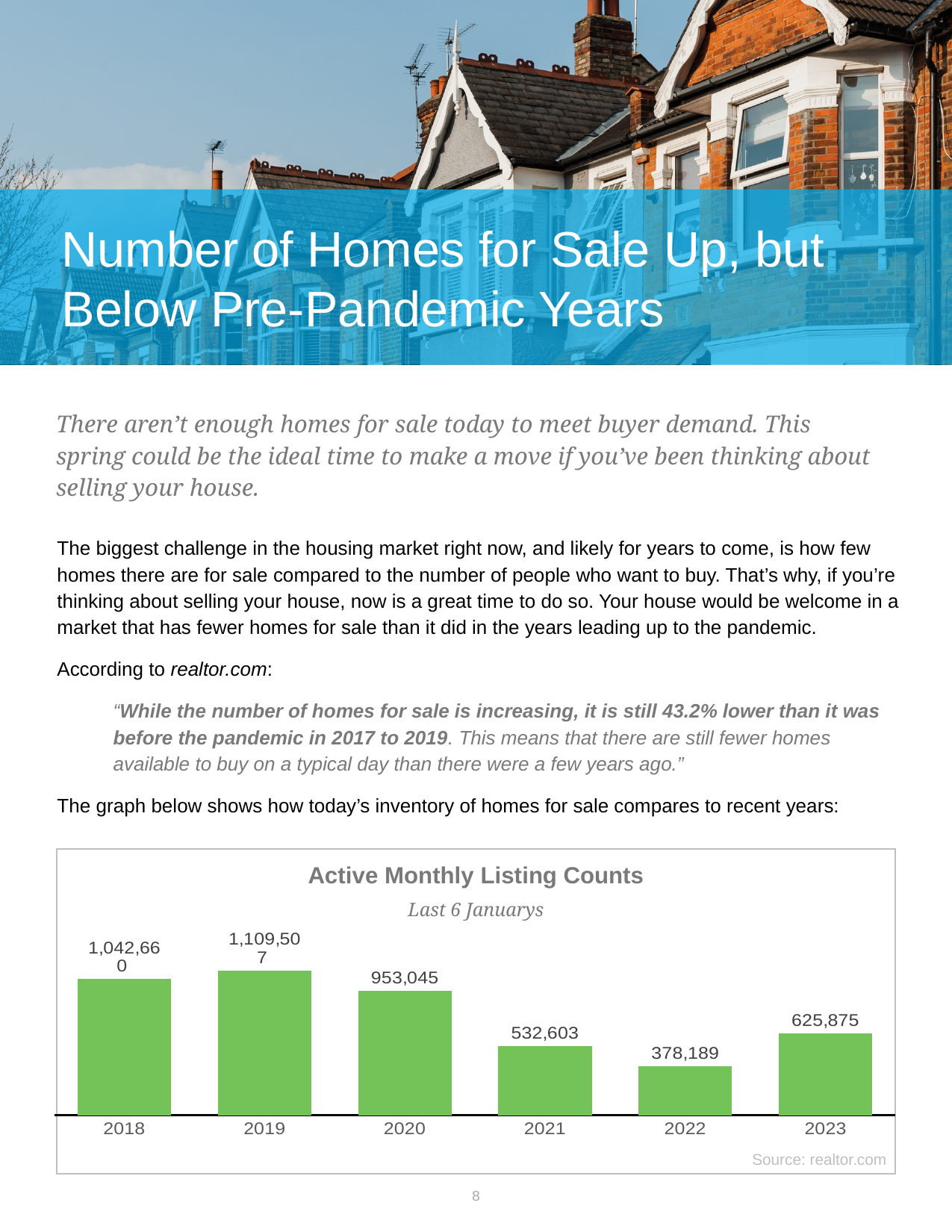
How many years are shown on the chart? 6 What is the difference between the listing counts for 2019 and 2018? 66,847 Do the listing counts rise or fall from 2019 to 2022? Fall Which year has the lowest active monthly listing count? 2022 What kind of chart is used to show the active monthly listing counts? Bar chart What is the active monthly listing count for January 2023? 625,875 Which year has a larger listing count, 2021 or 2023? 2023 What is the active monthly listing count for January 2022? 378,189 Which year has the highest active monthly listing count? 2019 What is the difference between the listing counts for 2023 and 2022? 247,686 What is the active monthly listing count for January 2020? 953,045 What is the title of the chart? Active Monthly Listing Counts